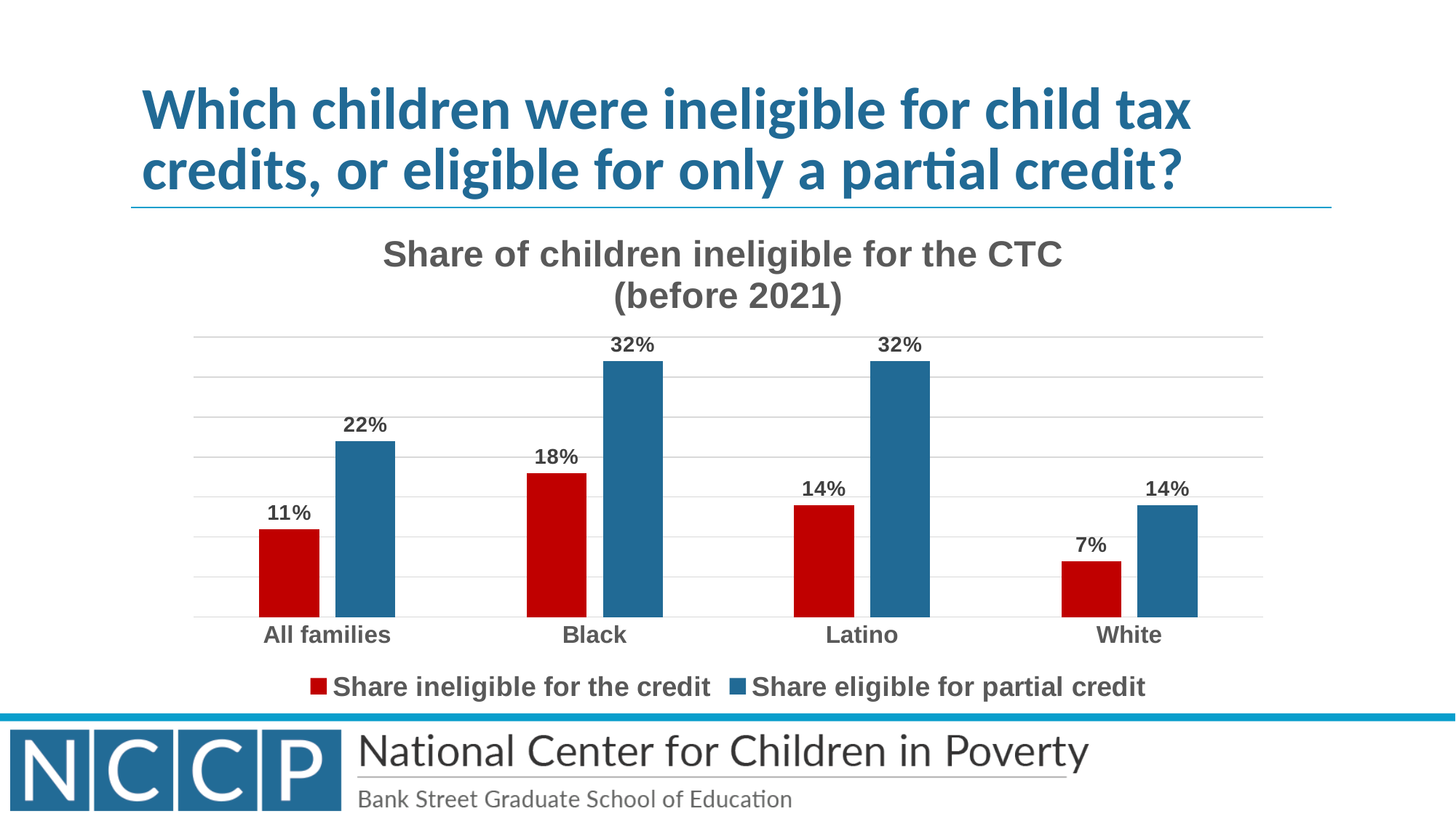
What is the share ineligible for the credit for White families? 7% Which is larger for White families: the share ineligible for the credit or the share eligible for partial credit? Share eligible for partial credit Which category has the highest share ineligible for the credit? Black What is the share eligible for partial credit for All families? 22% What is the difference between the share eligible for partial credit and the share ineligible for the credit for Latino families? 18% What colour are the bars for the share ineligible for the credit? Red How many series does the legend list? 2 What is the title of the chart? Share of children ineligible for the CTC (before 2021) What is the share of children ineligible for the credit for Black families? 18% How many categories are shown on the x axis? 4 Which category has the lowest share ineligible for the credit? White What kind of chart is shown on the slide? Bar chart